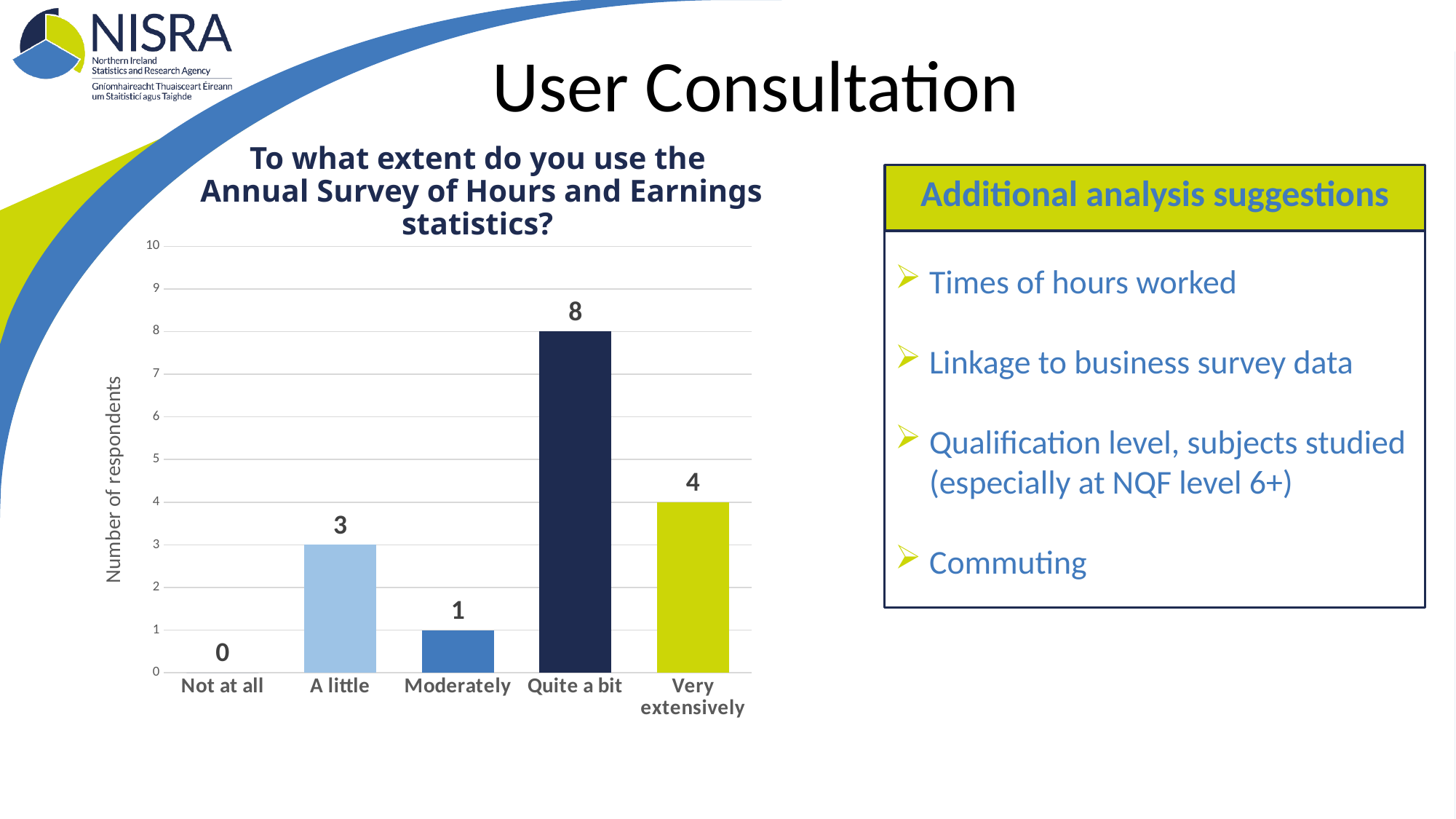
How many respondents answered 'Not at all'? 0 Which has more respondents, 'A little' or 'Moderately'? A little Which category has the highest number of respondents? Quite a bit How many categories are shown on the x axis? 5 What is the total number of respondents across all categories? 16 Which category has the lowest number of respondents? Not at all What is the label of the vertical axis? Number of respondents What kind of chart is shown on the slide? Bar chart How many respondents answered 'Quite a bit'? 8 How many respondents answered 'A little'? 3 How many respondents answered 'Very extensively'? 4 What is the difference in respondents between 'Quite a bit' and 'Very extensively'? 4